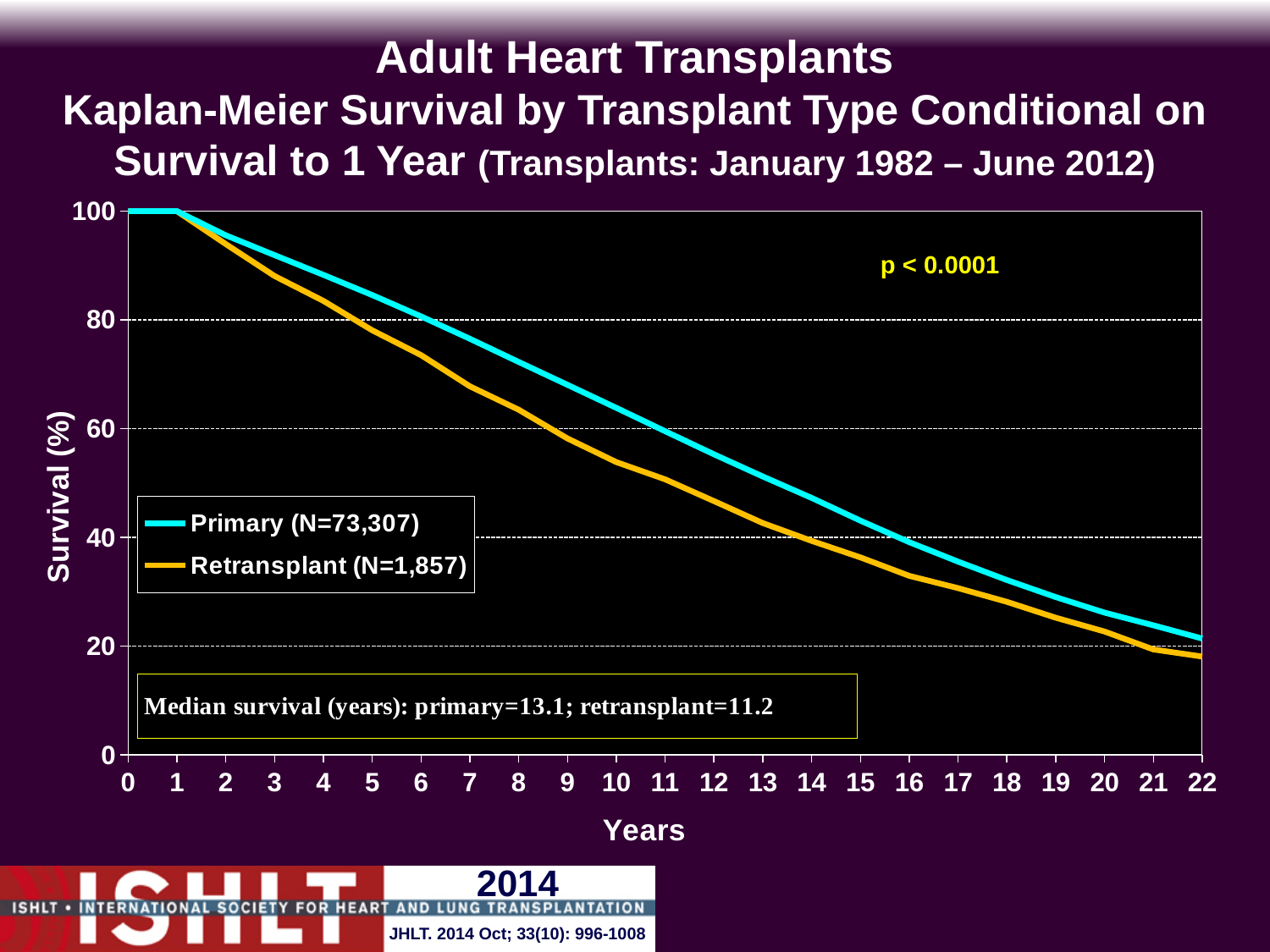
Do the survival curves rise or fall as years increase? fall Is the survival value for the Primary series at year 8 greater or less than 60? greater What p-value is shown on the chart? p < 0.0001 What is the median survival in years for the retransplant group? 11.2 How many patients (N) are in the Primary group? 73,307 Is the survival value for the Retransplant series at year 10 greater or less than 60? less At year 10, which series has the higher survival, Primary or Retransplant? Primary What kind of chart is shown on the slide? line chart What are the two series named in the legend? Primary (N=73,307) and Retransplant (N=1,857) How many series does the legend list? 2 What is the median survival in years for the primary transplant group? 13.1 What is the difference in median survival (years) between the primary and retransplant groups? 1.9